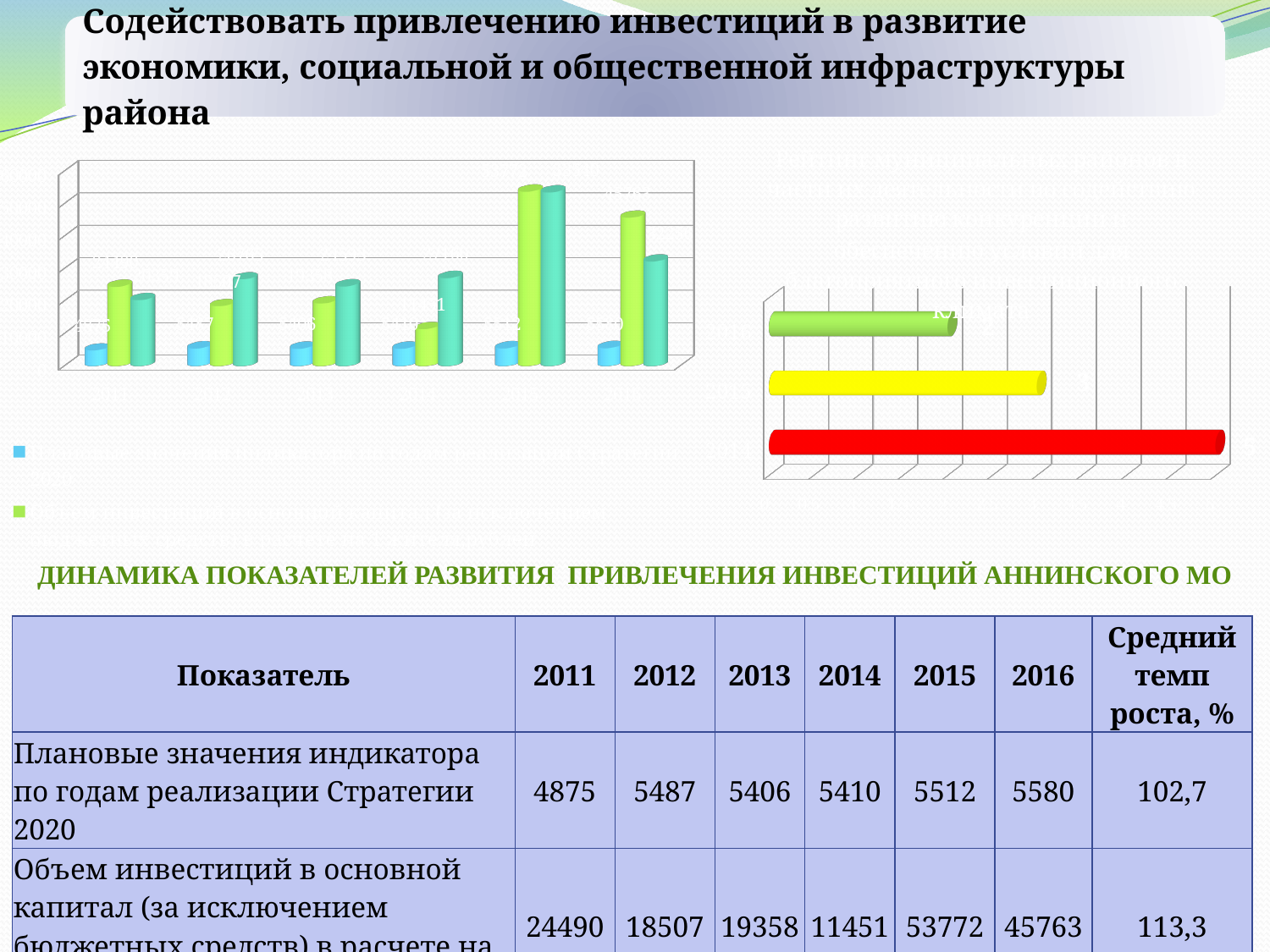
In the chart on the left side of the slide, which colour of bar is the shortest in every group? blue In the chart on the left side of the slide, is the green bar in the fifth group taller or shorter than the green bar in the sixth group? taller How many groups of bars does the chart on the left side of the slide show? 6 In the chart on the right side of the slide, which bar is the longest? the red bar (bottom) What kind of chart is the chart on the right side of the slide? bar chart In the chart on the right side of the slide, is the yellow bar longer or shorter than the red bar? shorter In the chart on the right side of the slide, which bar is the shortest? the green bar (top) In the chart on the left side of the slide, how many bars are in each group? 3 What colours are the three bars in the chart on the right side of the slide, from top to bottom? green, yellow, red How many bars does the chart on the right side of the slide show? 3 What kind of chart is the chart on the left side of the slide? bar chart In the chart on the left side of the slide, which group of bars (counting from the left) contains the tallest bar? the fifth group